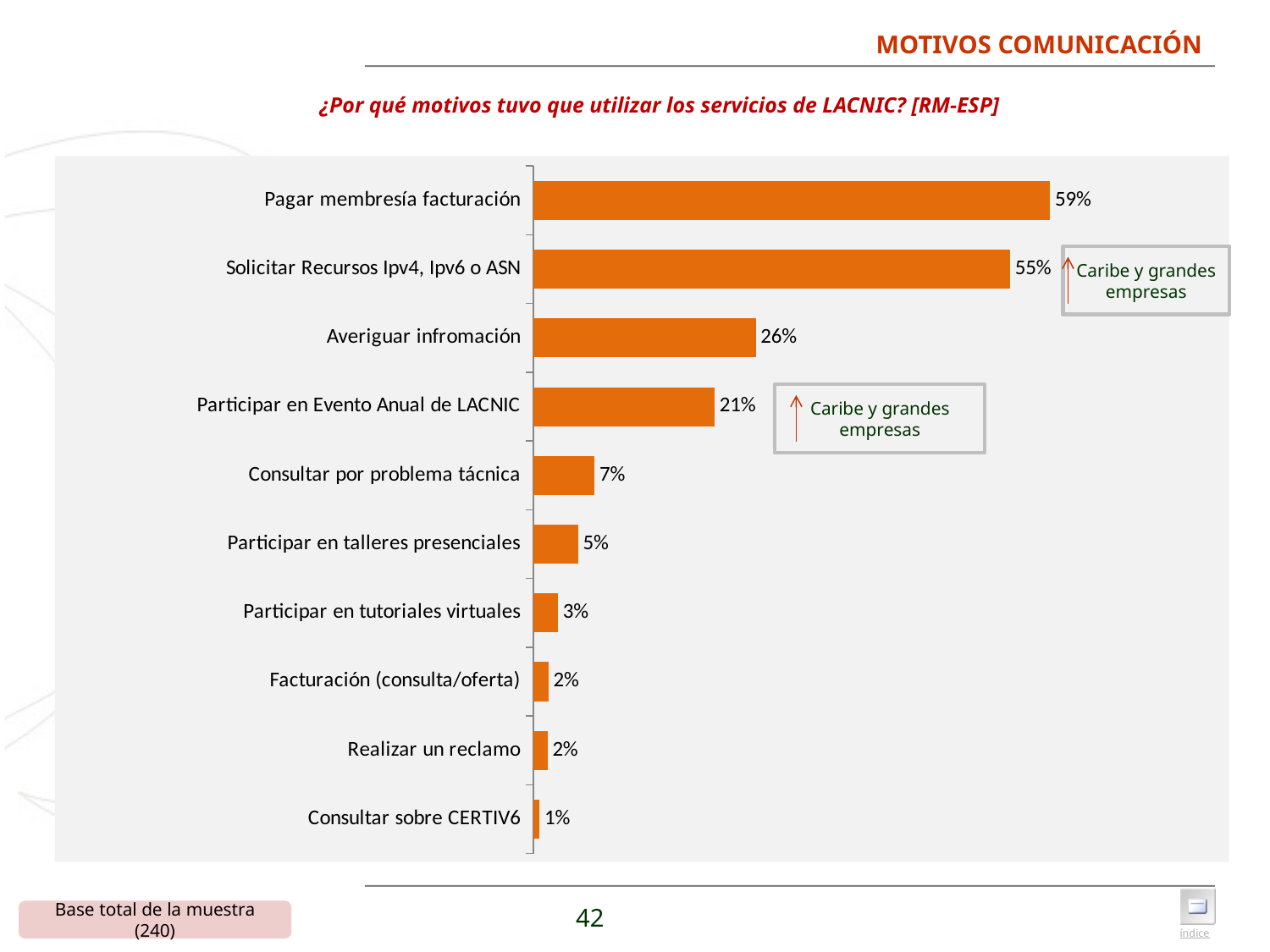
What percentage is shown for "Participar en Evento Anual de LACNIC"? 21% Which is larger: "Participar en talleres presenciales" or "Participar en tutoriales virtuales"? Participar en talleres presenciales Which category has the lowest value? Consultar sobre CERTIV6 What colour are the bars in the chart? Orange What is the difference between "Averiguar infromación" and "Participar en Evento Anual de LACNIC"? 5% What kind of chart is shown on the slide? Bar chart What is the difference between "Pagar membresía facturación" and "Solicitar Recursos Ipv4, Ipv6 o ASN"? 4% What percentage is shown for "Pagar membresía facturación"? 59% What is the value for "Averiguar infromación"? 26% Which category has the highest value? Pagar membresía facturación How many categories are shown in the chart? 10 What is the value for "Consultar por problema tácnica"? 7%